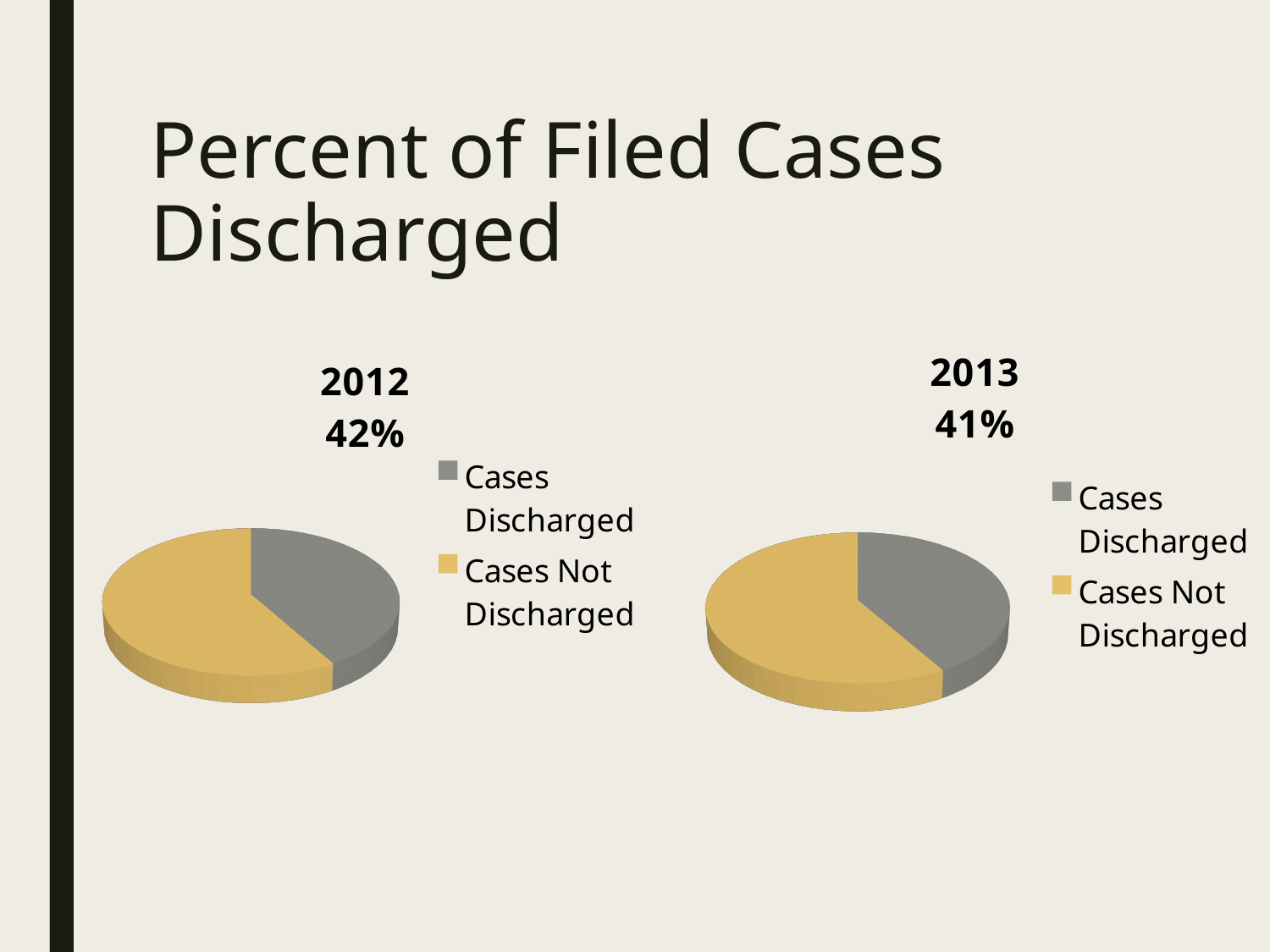
In the 2013 chart, what colour is the Cases Not Discharged slice? gold In the 2012 chart, which slice is the largest? Cases Not Discharged What is the difference between the percentages shown in the 2012 and 2013 chart titles? 1% How many charts are on the slide? 2 What kind of chart is used for the 2012 data? pie chart In the 2013 chart, how many entries does the legend list? 2 In the 2013 chart, which slice is the smallest? Cases Discharged What percentage is shown in the title of the 2012 chart? 42% In the 2012 chart, which slice is larger, Cases Discharged or Cases Not Discharged? Cases Not Discharged What percentage is shown in the title of the 2013 chart? 41% Which year's chart shows the higher percentage of filed cases discharged, 2012 or 2013? 2012 In the 2012 chart, how many slices does the pie have? 2